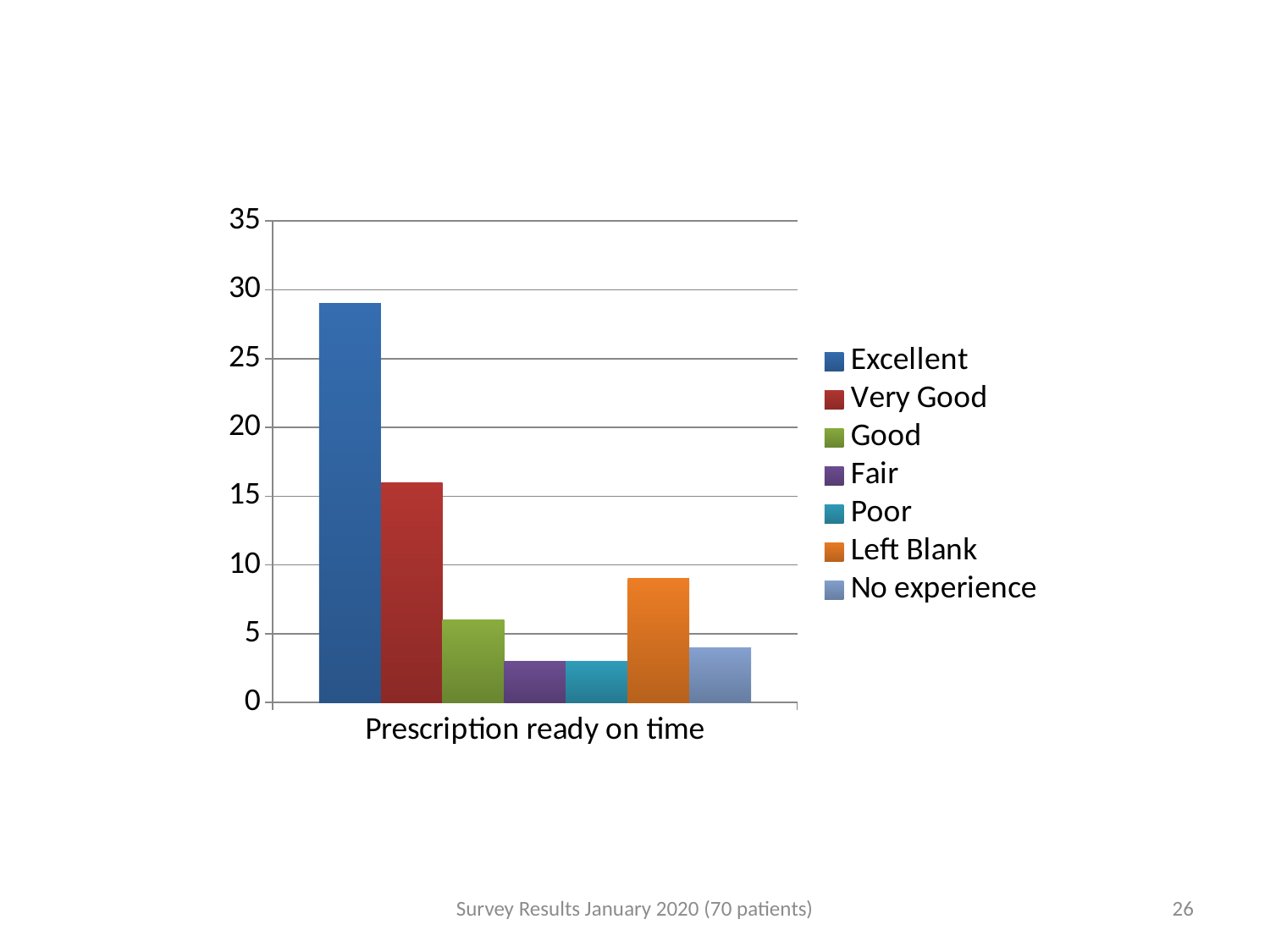
Which series has the highest value? Excellent Which is larger, the value for Left Blank or the value for Good? Left Blank Is the value for Fair greater or less than 5? less Is the value for Left Blank greater or less than 5? greater Is the value for Excellent greater or less than 25? greater How many series does the legend list? 7 What colour is the bar for Left Blank? orange What kind of chart is shown on the slide? bar chart Which is larger, the value for Very Good or the value for Left Blank? Very Good What is the category label shown on the x axis? Prescription ready on time